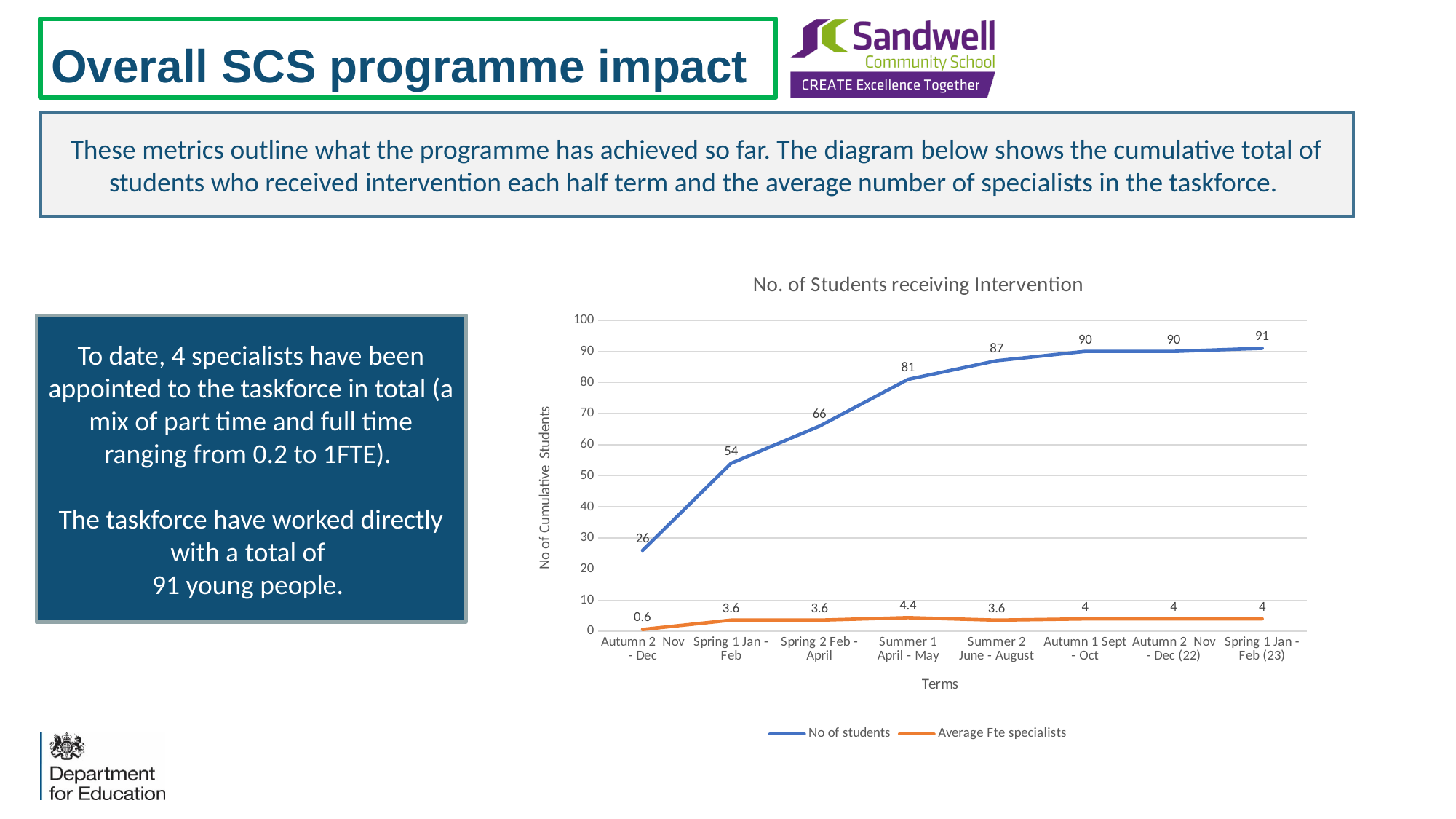
How many terms are plotted along the x axis? 8 Does the number of students rise or fall across the terms from left to right? Rise How many series does the chart legend list? 2 In which term is the average Fte specialists value highest? Summer 1 April - May What is the number of students for Summer 1 April - May? 81 What is the average Fte specialists value for Autumn 2 Nov - Dec? 0.6 What is the difference in number of students between Spring 1 Jan - Feb and Autumn 2 Nov - Dec? 28 In which term is the number of students highest? Spring 1 Jan - Feb (23) What is the average Fte specialists value for Summer 2 June - August? 3.6 Which is larger: the number of students in Spring 2 Feb - April or in Summer 2 June - August? Summer 2 June - August What is the title of the chart? No. of Students receiving Intervention What type of chart is shown on the slide? Line chart